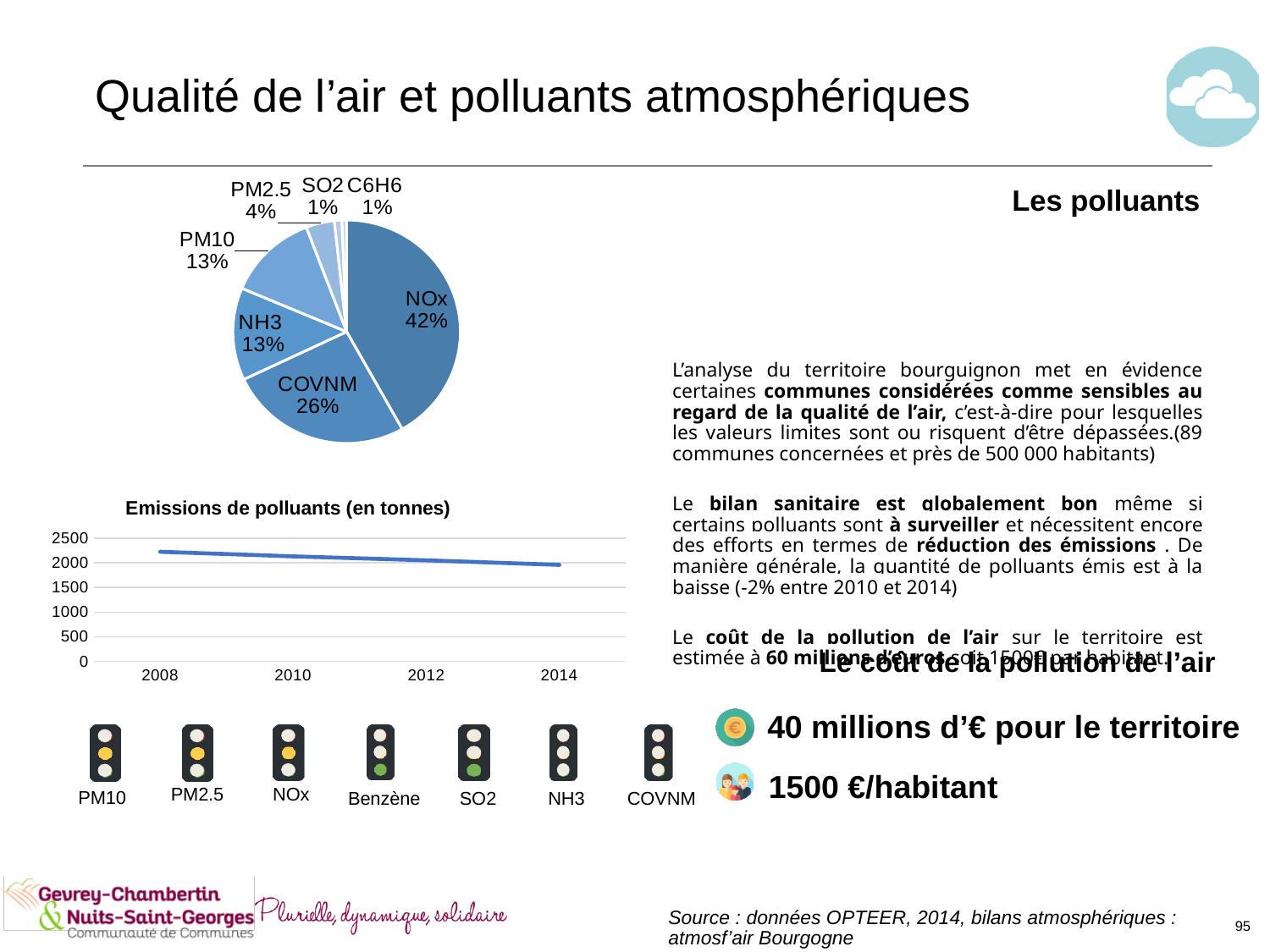
In the pie chart at the top left, what is the difference in percentage points between the NOx and COVNM shares? 16 In the pie chart at the top left, what share does COVNM have? 26% In the chart titled 'Emissions de polluants (en tonnes)', do the values rise or fall from 2008 to 2014? fall In the pie chart at the top left, what share does SO2 have? 1% In the pie chart at the top left, what share does NOx have? 42% In the chart titled 'Emissions de polluants (en tonnes)', how many years are shown on the x axis? 4 In the chart titled 'Emissions de polluants (en tonnes)', is the value for 2014 greater or less than 1500? greater In the pie chart at the top left, which is larger, the share of NH3 or the share of PM2.5? NH3 What kind of chart is the chart titled 'Emissions de polluants (en tonnes)'? line chart In the pie chart at the top left, how many slices are there? 7 In the pie chart at the top left, which pollutant has the largest slice? NOx